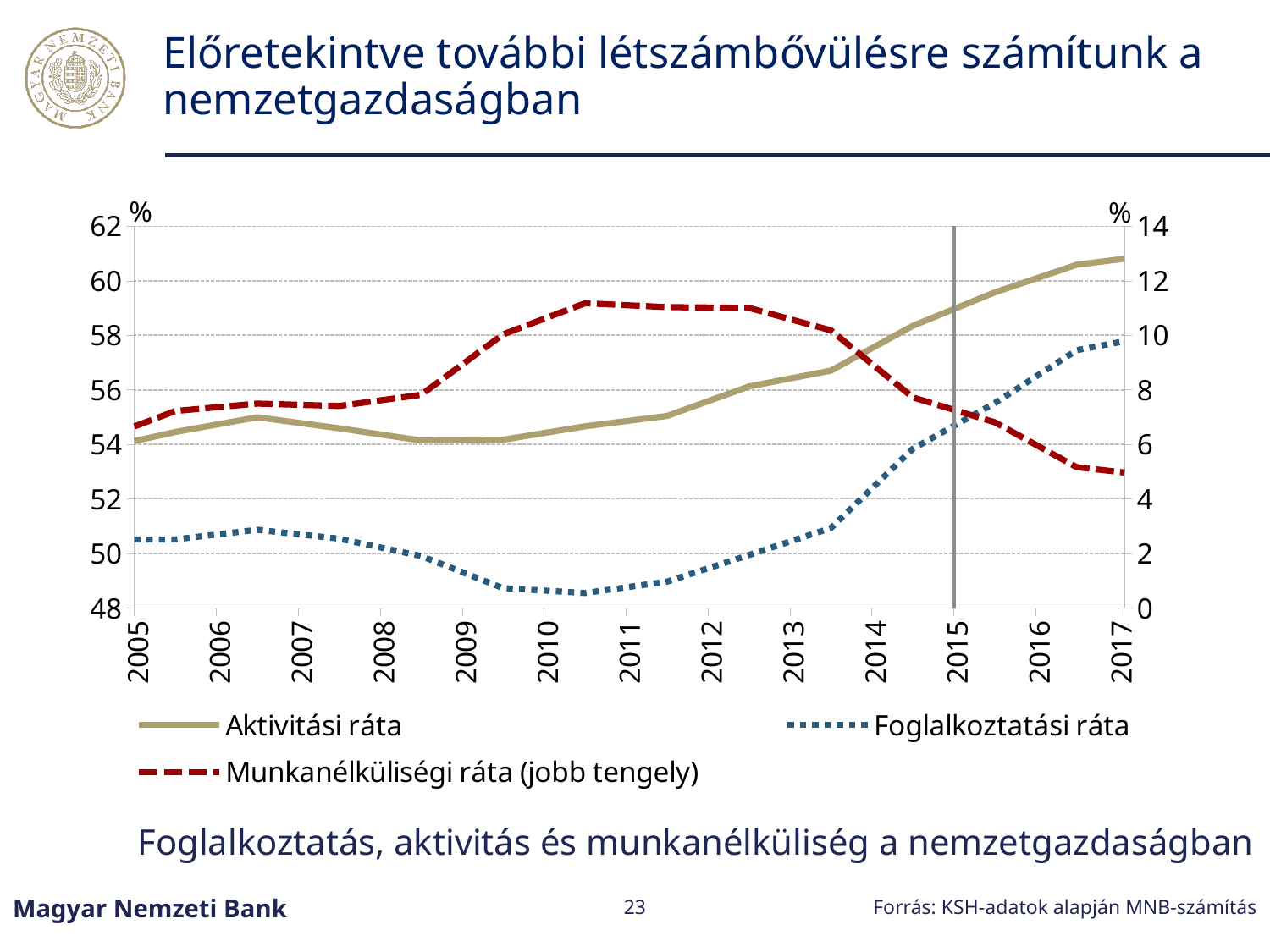
Is the value of Munkanélküliségi ráta in 2017 greater or less than 6 on the right axis? less Does the Aktivitási ráta rise or fall between 2013 and 2017? rise Is the value of Aktivitási ráta in 2017 greater or less than 60? greater Does the Munkanélküliségi ráta rise or fall between 2013 and 2017? fall In 2017, which is higher: Aktivitási ráta or Foglalkoztatási ráta? Aktivitási ráta Which series is plotted on the right axis (jobb tengely)? Munkanélküliségi ráta Is the value of Munkanélküliségi ráta in 2011 greater or less than 10 on the right axis? greater How many years are labelled on the x axis? 13 What kind of chart is shown on the slide? line chart What is the title of the chart? Foglalkoztatás, aktivitás és munkanélküliség a nemzetgazdaságban How many series does the legend list? 3